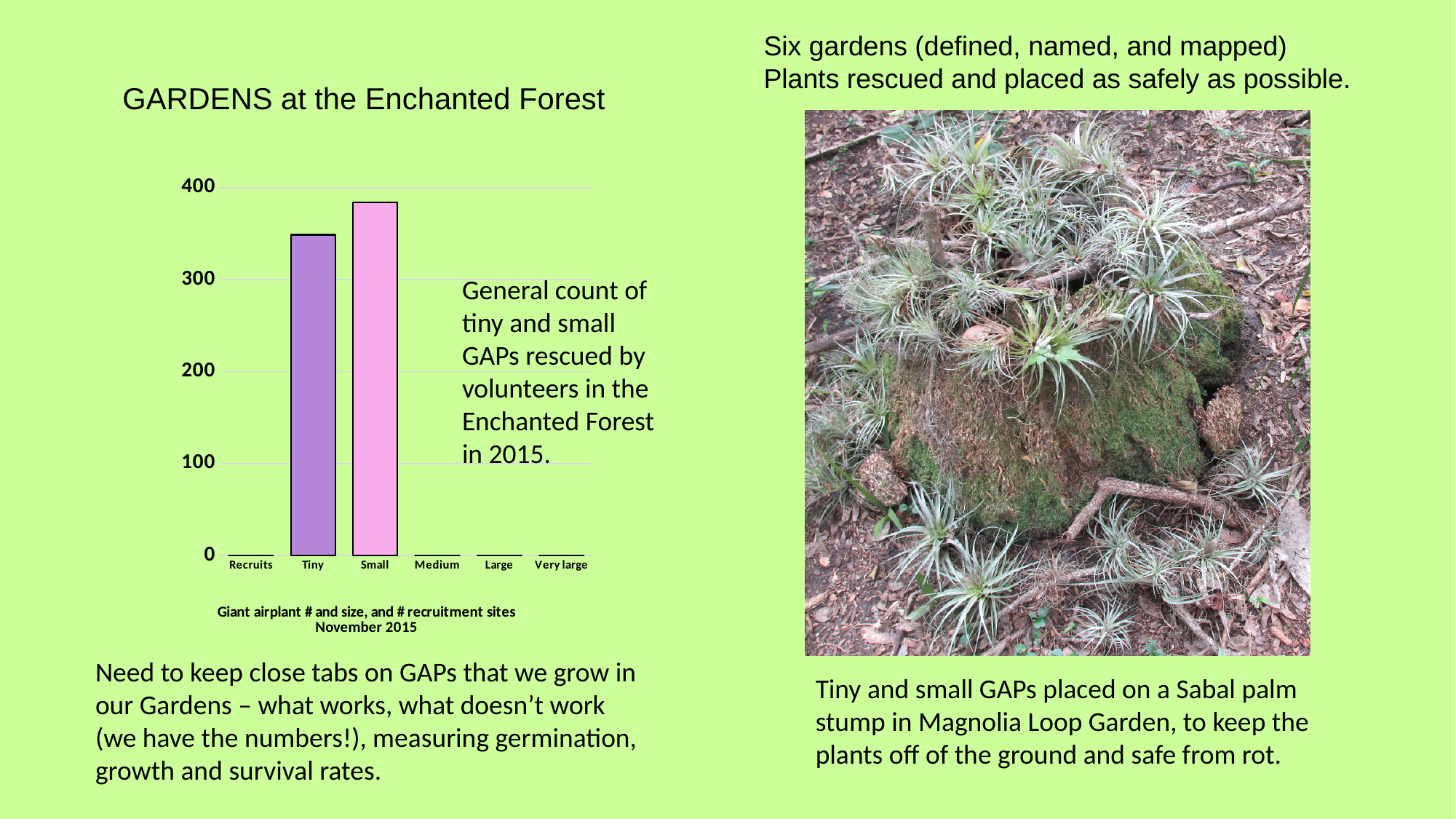
What kind of chart is shown on the slide? bar chart Is the value for Small greater or less than 400? less Which category has the highest value in the chart? Small Is the value for Tiny greater or less than 300? greater Which is larger, the value for Tiny or the value for Small? Small How many categories are shown on the x axis of the chart? 6 Is the value for Tiny greater or less than 400? less How many categories in the chart have a visible bar above zero? 2 What is the highest value labelled on the vertical axis of the chart? 400 What colour is the bar for Tiny? purple